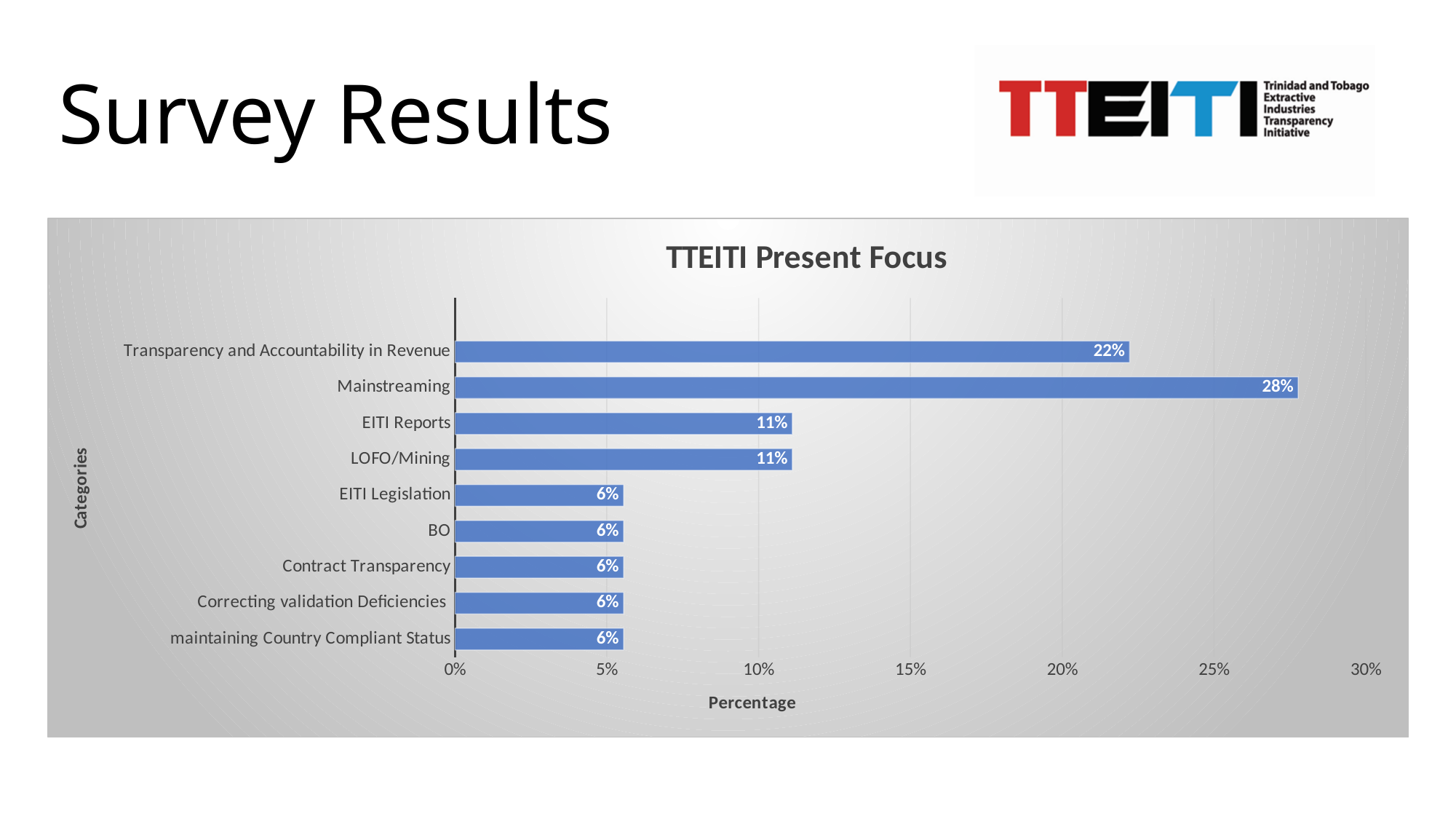
Which is larger, the value for LOFO/Mining or the value for BO? LOFO/Mining Which category has the highest value? Mainstreaming What is the value for Mainstreaming? 28% How many categories are shown in the chart? 9 What is the value for Contract Transparency? 6% Is the value for Mainstreaming greater or less than 25%? greater What kind of chart is shown on the slide? Bar chart What is the value for EITI Reports? 11% What is the difference between the values for EITI Reports and EITI Legislation? 5% What is the title of the chart? TTEITI Present Focus What is the value for Transparency and Accountability in Revenue? 22% What is the difference between the values for Mainstreaming and Transparency and Accountability in Revenue? 6%